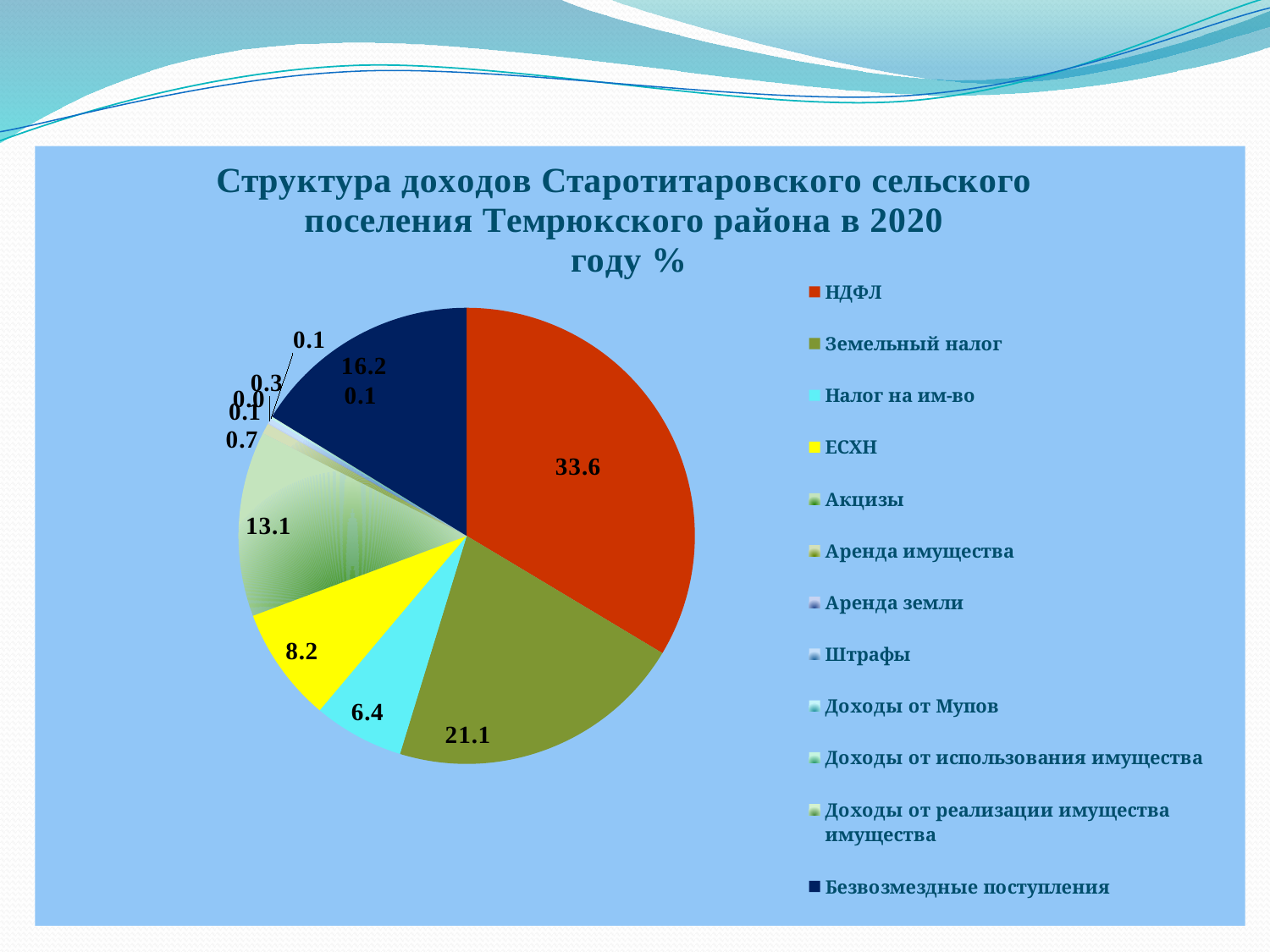
What is the value for НДФЛ? 33.6 What is the value for Земельный налог? 21.1 Which category has the largest share of the pie? НДФЛ How many entries does the legend list? 12 What kind of chart is shown on the slide? pie chart What is the value for ЕСХН? 8.2 Which is larger, the value for Акцизы or the value for ЕСХН? Акцизы What is the value for Налог на им-во? 6.4 What is the difference between the values for НДФЛ and Земельный налог? 12.5 What is the value for Безвозмездные поступления? 16.2 Which year does the chart title refer to? 2020 What is the value for Акцизы? 13.1